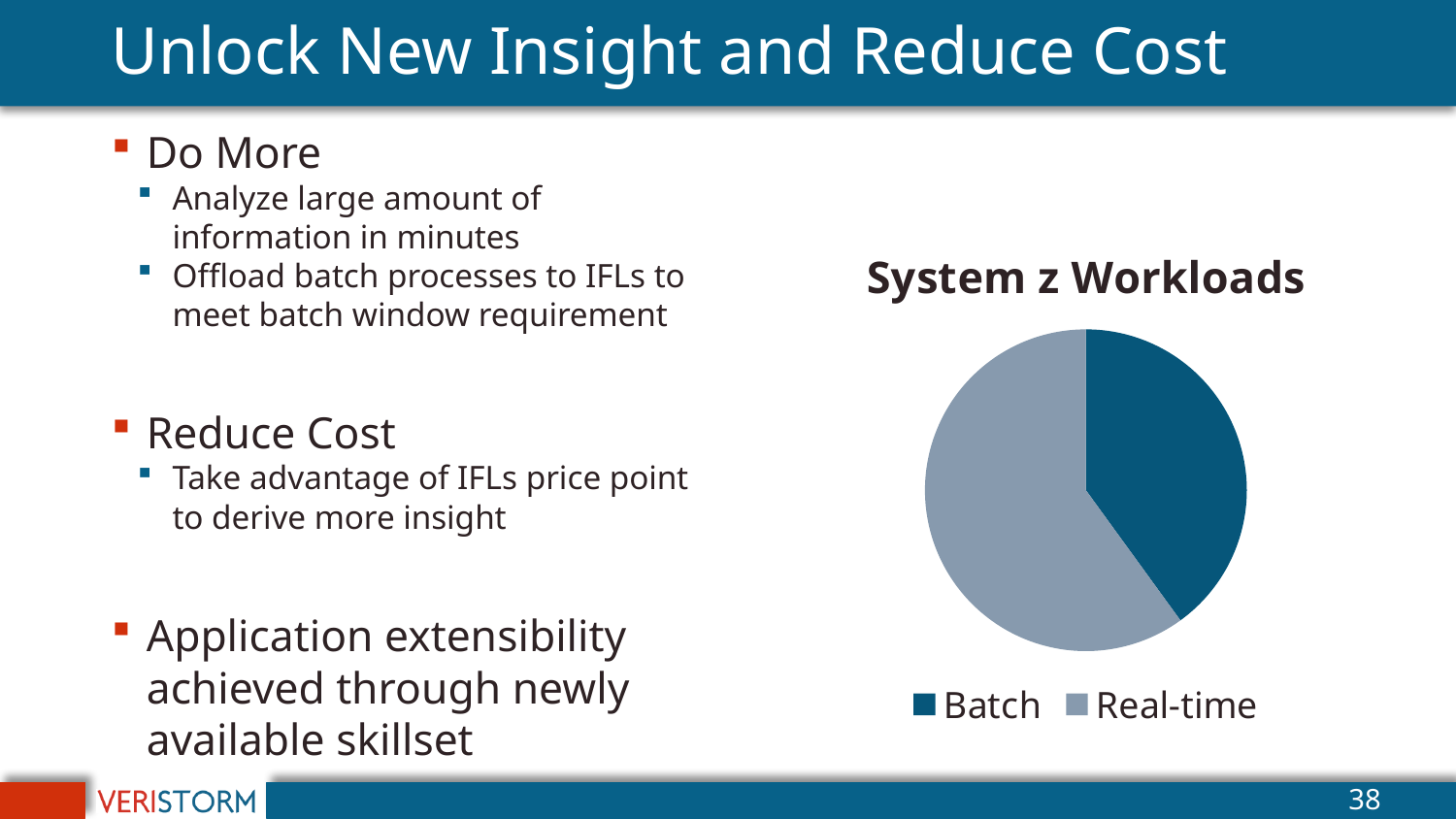
What is the title of the chart? System z Workloads Which slice of the pie chart is the smallest? Batch Which legend entry is shown in dark blue? Batch How many slices does the pie chart have? 2 How many entries does the chart legend list? 2 Which is larger in the pie chart, Batch or Real-time? Real-time Which slice of the pie chart is the largest? Real-time What kind of chart is shown on the slide? pie chart